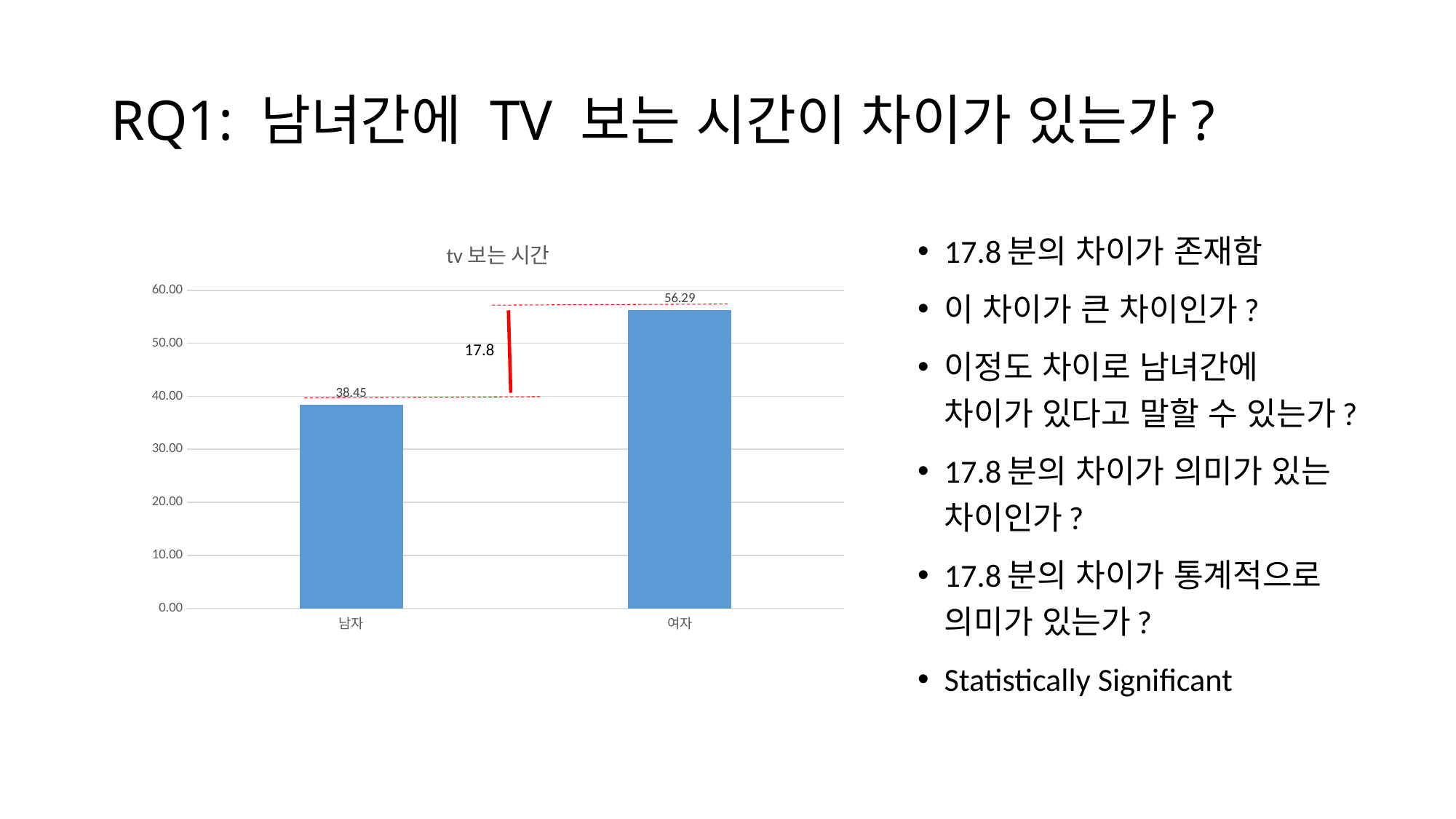
What kind of chart is shown? bar chart Which category has the lowest value? 남자 Which category has the highest value? 여자 What is the value for 남자? 38.45 Is the value for 남자 greater or less than 40.00? less What is the title of the chart? tv 보는 시간 What is the value for 여자? 56.29 Is the value for 여자 greater or less than 50.00? greater How many categories are shown on the x axis? 2 What is the difference between the values for 여자 and 남자? 17.84 What difference value is annotated in red between the two bars? 17.8 Which is larger, the value for 남자 or the value for 여자? 여자